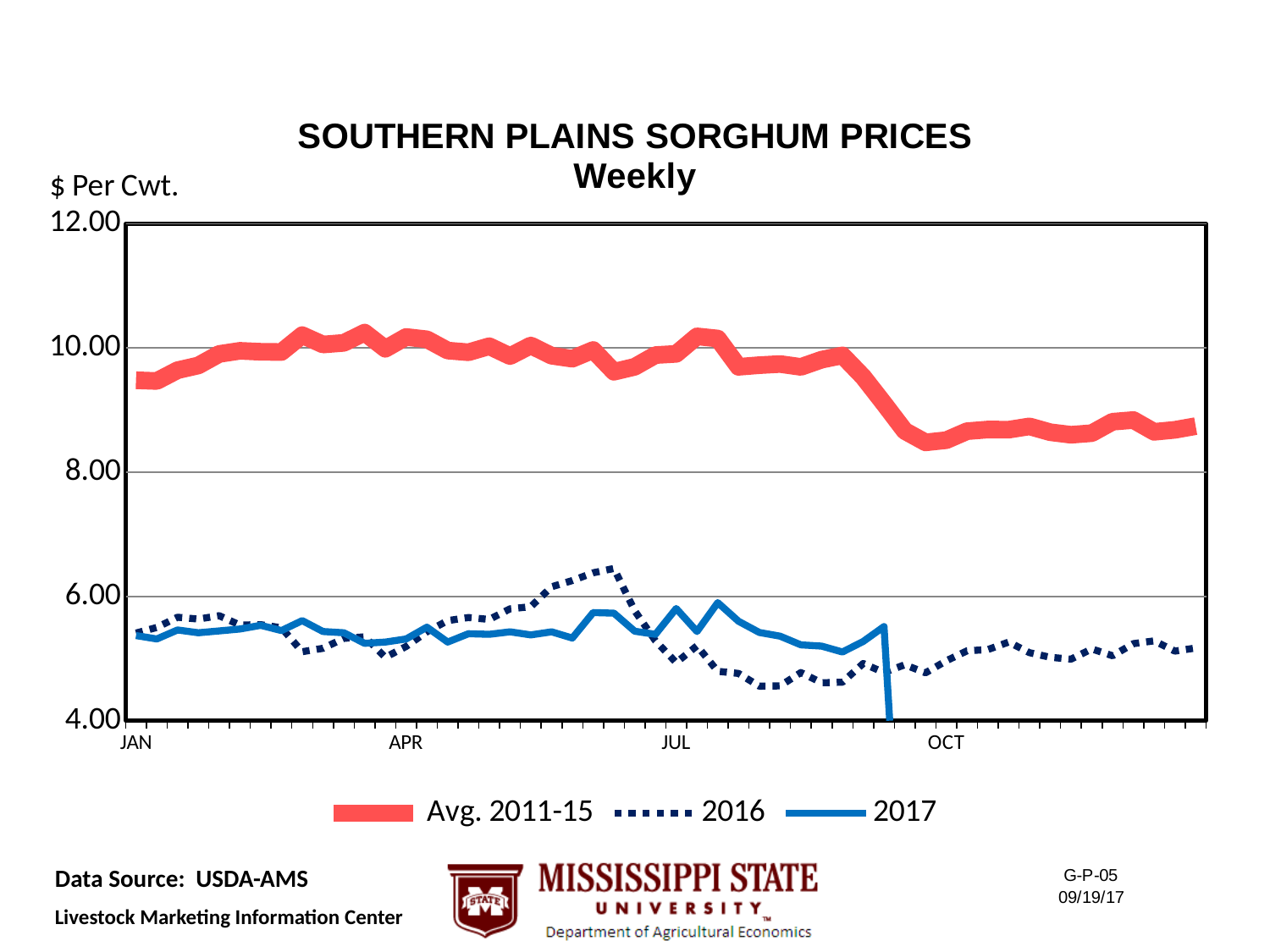
Which series has the lowest values in October? 2016 What unit label is shown on the y axis? $ Per Cwt. What is the title of the chart? SOUTHERN PLAINS SORGHUM PRICES Weekly Does the Avg. 2011-15 line rise or fall between July and October? fall What kind of chart is shown on the slide? line chart Is the highest point of the 2016 line greater or less than 6.00? greater Is the Avg. 2011-15 value in January greater or less than 8.00? greater Is the Avg. 2011-15 value in October greater or less than 10.00? less How many month labels are shown on the x axis? 4 How many series does the legend list? 3 Which series is higher in January, Avg. 2011-15 or 2017? Avg. 2011-15